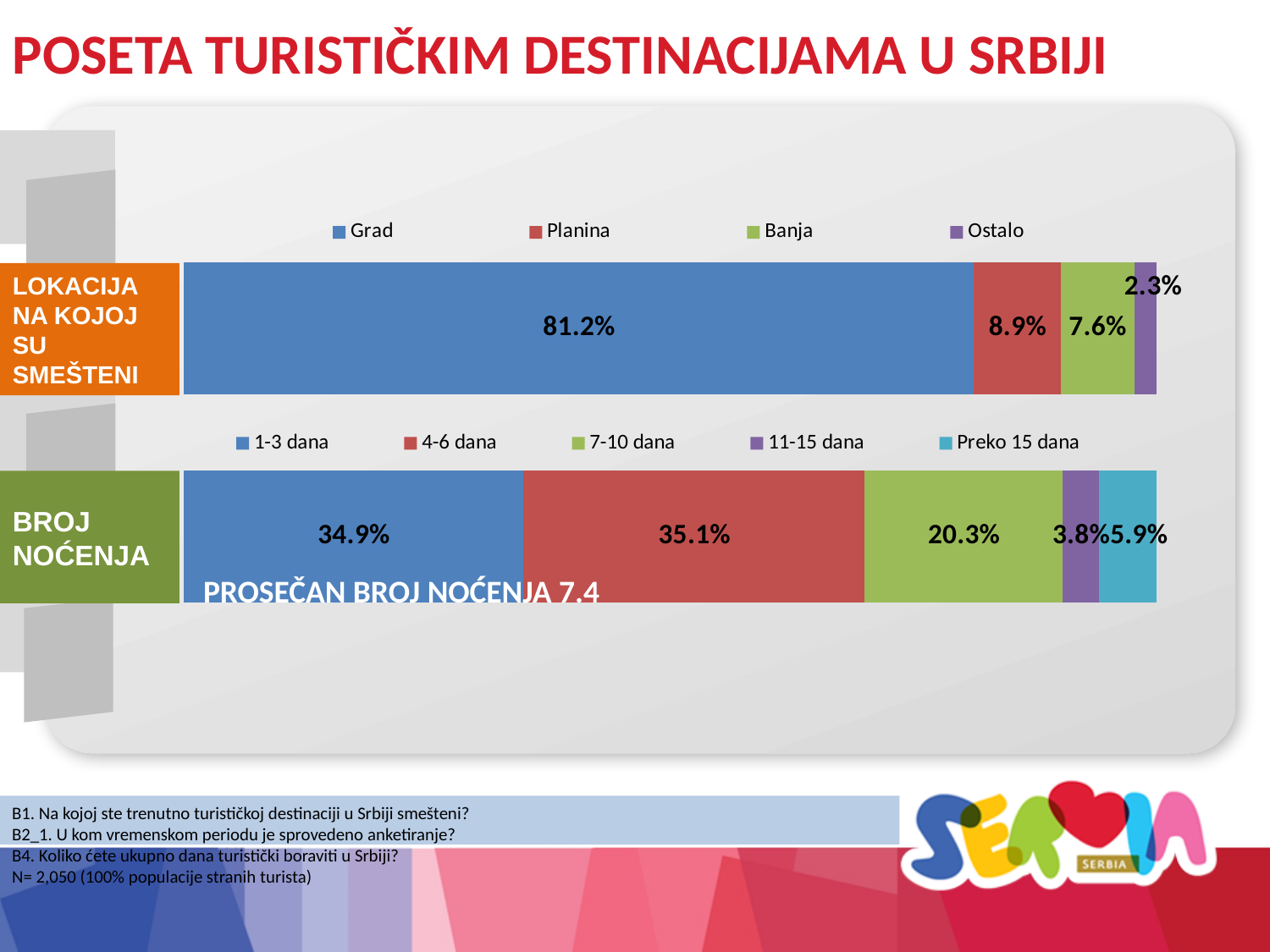
In the BROJ NOĆENJA chart, what percentage is shown for Preko 15 dana? 5.9% In the LOKACIJA NA KOJOJ SU SMEŠTENI chart, what percentage is shown for Grad? 81.2% In the BROJ NOĆENJA chart, which category has the highest share? 4-6 dana In the BROJ NOĆENJA chart, which is larger: 4-6 dana or 7-10 dana? 4-6 dana How many series does the legend of the BROJ NOĆENJA chart list? 5 In the LOKACIJA NA KOJOJ SU SMEŠTENI chart, which category has the lowest share? Ostalo What type of chart is used for BROJ NOĆENJA? Stacked bar chart How many series does the legend of the LOKACIJA NA KOJOJ SU SMEŠTENI chart list? 4 In the BROJ NOĆENJA chart, which category has the lowest share? 11-15 dana In the LOKACIJA NA KOJOJ SU SMEŠTENI chart, what is the difference between Planina and Banja? 1.3% In the LOKACIJA NA KOJOJ SU SMEŠTENI chart, what percentage is shown for Banja? 7.6% In the BROJ NOĆENJA chart, what percentage is shown for 7-10 dana? 20.3%